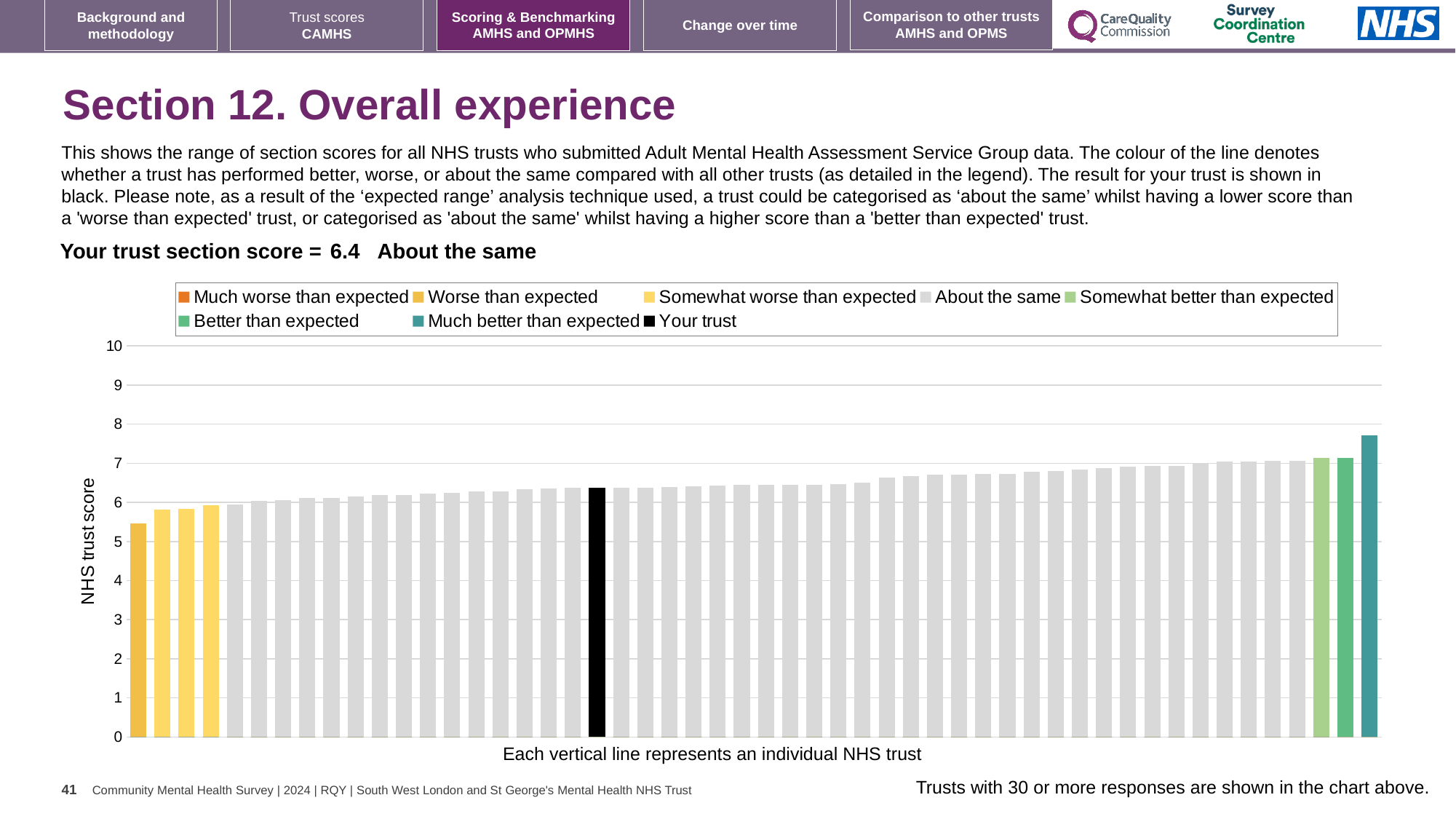
Which legend category does the highest-scoring trust belong to? Much better than expected Is the value for your trust greater or less than 6? greater Is the value for your trust greater or less than 7? less Is the value of the shortest bar greater or less than 6? less How many entries does the chart legend list? 8 Do the bar values rise or fall from left to right along the x axis? rise What kind of chart is shown on the slide? bar chart What colour is the bar representing your trust? black What is the section score for your trust shown on the slide? 6.4 Which performance category is your trust placed in for this section? About the same